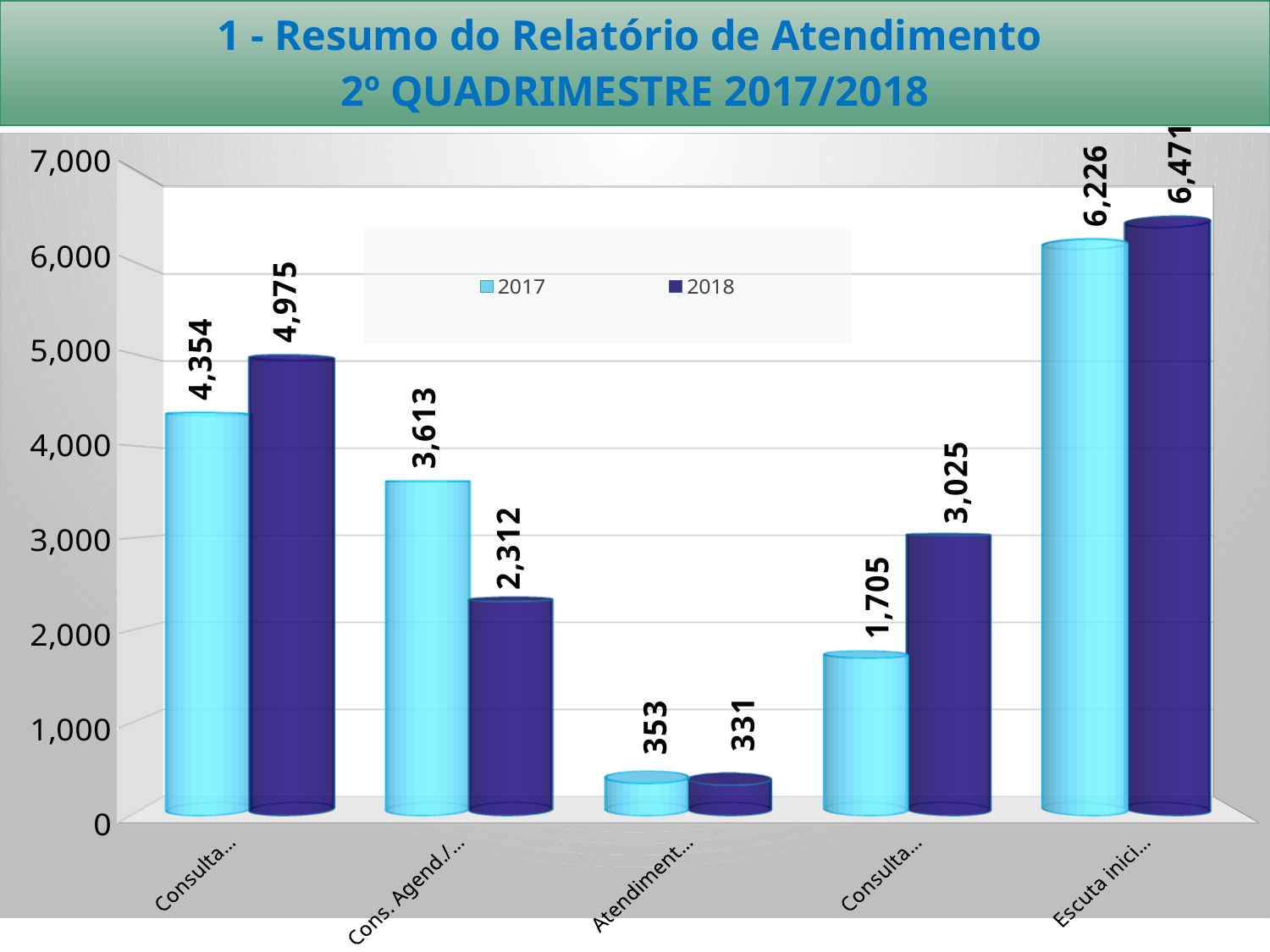
What is the 2018 value for the leftmost category on the chart? 4,975 For the category labelled "Escuta inici...", what is the difference between the 2018 and 2017 values? 245 What is the 2017 value for the category labelled "Atendiment..."? 353 What kind of chart is shown on the slide? Bar chart Which category has the lowest 2017 value? Atendiment... What is the 2017 value for the category labelled "Cons. Agend./..."? 3,613 Which category has the highest 2018 value? Escuta inici... How many categories are shown on the x axis? 5 For the fourth category from the left, what is the difference between the 2018 and 2017 values? 1,320 For the category labelled "Cons. Agend./...", which year has the larger value, 2017 or 2018? 2017 How many series does the legend list? 2 What is the 2018 value for the category labelled "Escuta inici..."? 6,471